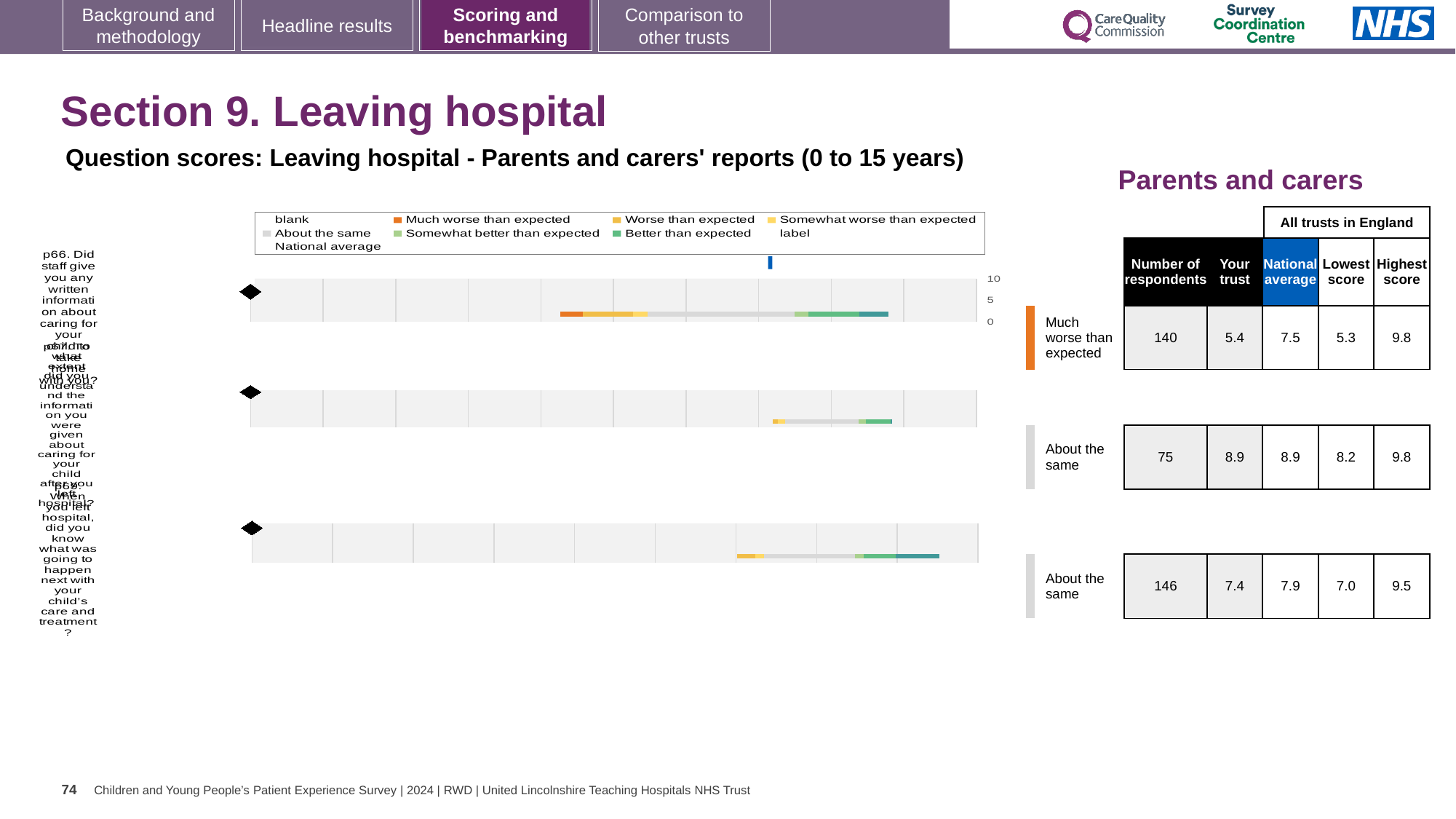
How many question rows (charts) are shown in the Leaving hospital section on this slide? 3 In the Parents and carers table, what is the number of respondents for the first row (rated 'Much worse than expected')? 140 In the Parents and carers table, for the first row, which is larger: the 'Your trust' score or the national average? National average In the Parents and carers table, what is the 'Your trust' score for the first row (rated 'Much worse than expected')? 5.4 In the Parents and carers table, what is the 'Your trust' score for the third row (146 respondents)? 7.4 In the Parents and carers table, what is the difference between the national average and the 'Your trust' score for the third row (146 respondents)? 0.5 In the chart legend, what colour represents 'Much worse than expected'? orange In the Parents and carers table, which row has the highest number of respondents? the third row (146) In the Parents and carers table, what is the highest score for the second row (75 respondents)? 9.8 In the Parents and carers table, what is the national average for the first row (rated 'Much worse than expected')? 7.5 In the Parents and carers table, what is the lowest score for the third row (146 respondents)? 7.0 What kind of chart is used to show the question scores on this slide? bar chart